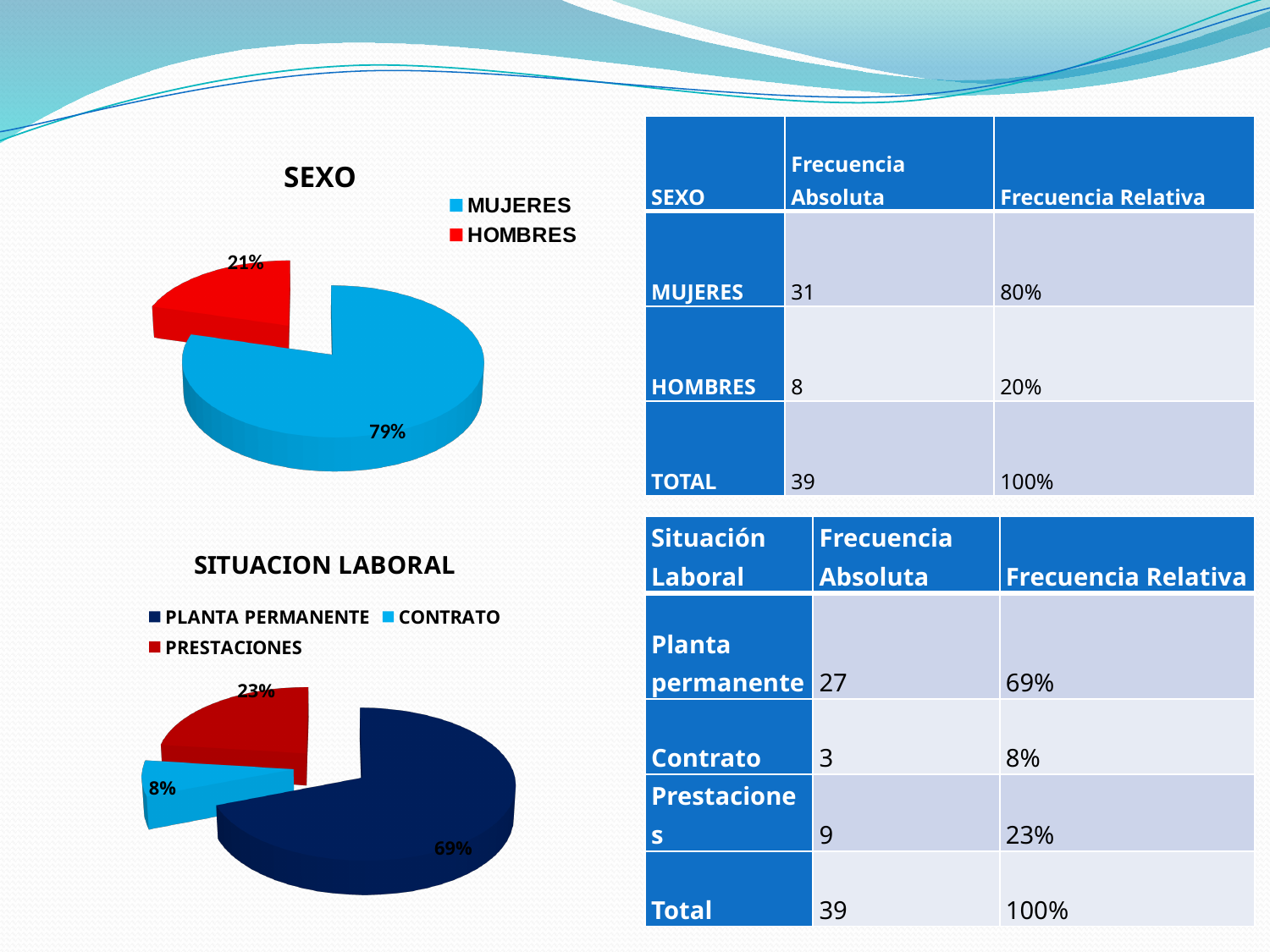
What kind of chart is the SEXO chart? Pie chart In the SITUACION LABORAL chart, which category has the smallest slice? CONTRATO How many series does the legend of the SEXO chart list? 2 In the SEXO chart, what percentage is shown for HOMBRES? 21% In the SEXO chart, what percentage is shown for MUJERES? 79% In the SITUACION LABORAL chart, which is larger, PRESTACIONES or CONTRATO? PRESTACIONES In the SEXO chart, which category has the largest slice? MUJERES In the SITUACION LABORAL chart, what percentage is shown for PRESTACIONES? 23% In the SITUACION LABORAL chart, what percentage is shown for PLANTA PERMANENTE? 69% In the SITUACION LABORAL chart, what percentage is shown for CONTRATO? 8% In the SEXO chart, what is the difference in percentage points between MUJERES and HOMBRES? 58 How many categories does the SITUACION LABORAL chart show? 3